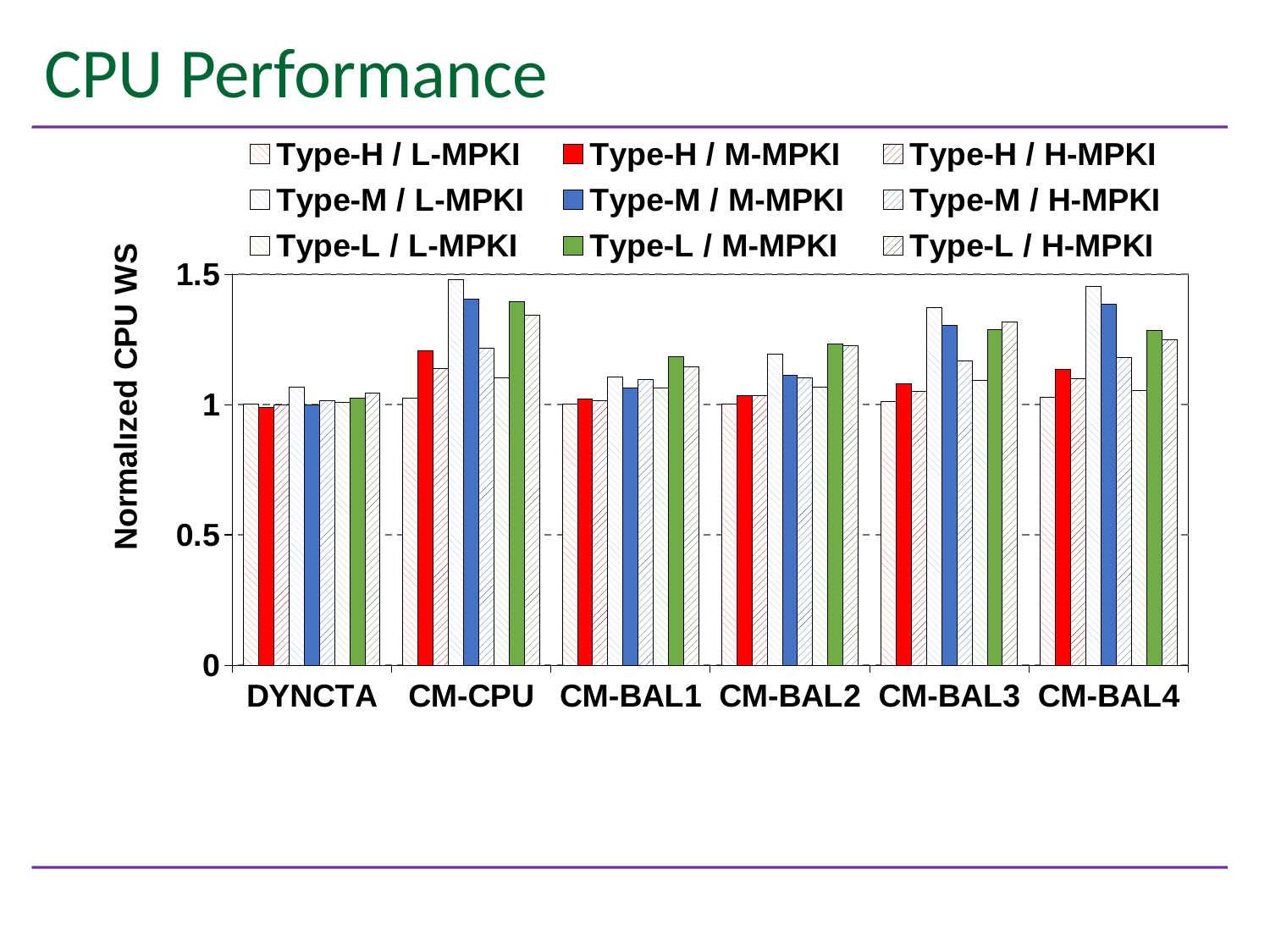
Which category has the highest Type-L / M-MPKI value? CM-CPU How many categories are shown on the x axis of the chart? 6 Is the value for Type-M / L-MPKI at CM-CPU greater or less than 1? greater What is the title of the slide containing the chart? CPU Performance What kind of chart is shown on the slide? bar chart Which category has the lowest Type-L / M-MPKI value? DYNCTA What is the label of the y axis of the chart? Normalized CPU WS Is the value for Type-L / M-MPKI at CM-BAL2 greater or less than 1.5? less Is the value for Type-L / M-MPKI at CM-BAL3 greater or less than 1? greater How many series does the legend of the chart list? 9 Which is larger, the Type-M / L-MPKI value for CM-CPU or for CM-BAL1? CM-CPU